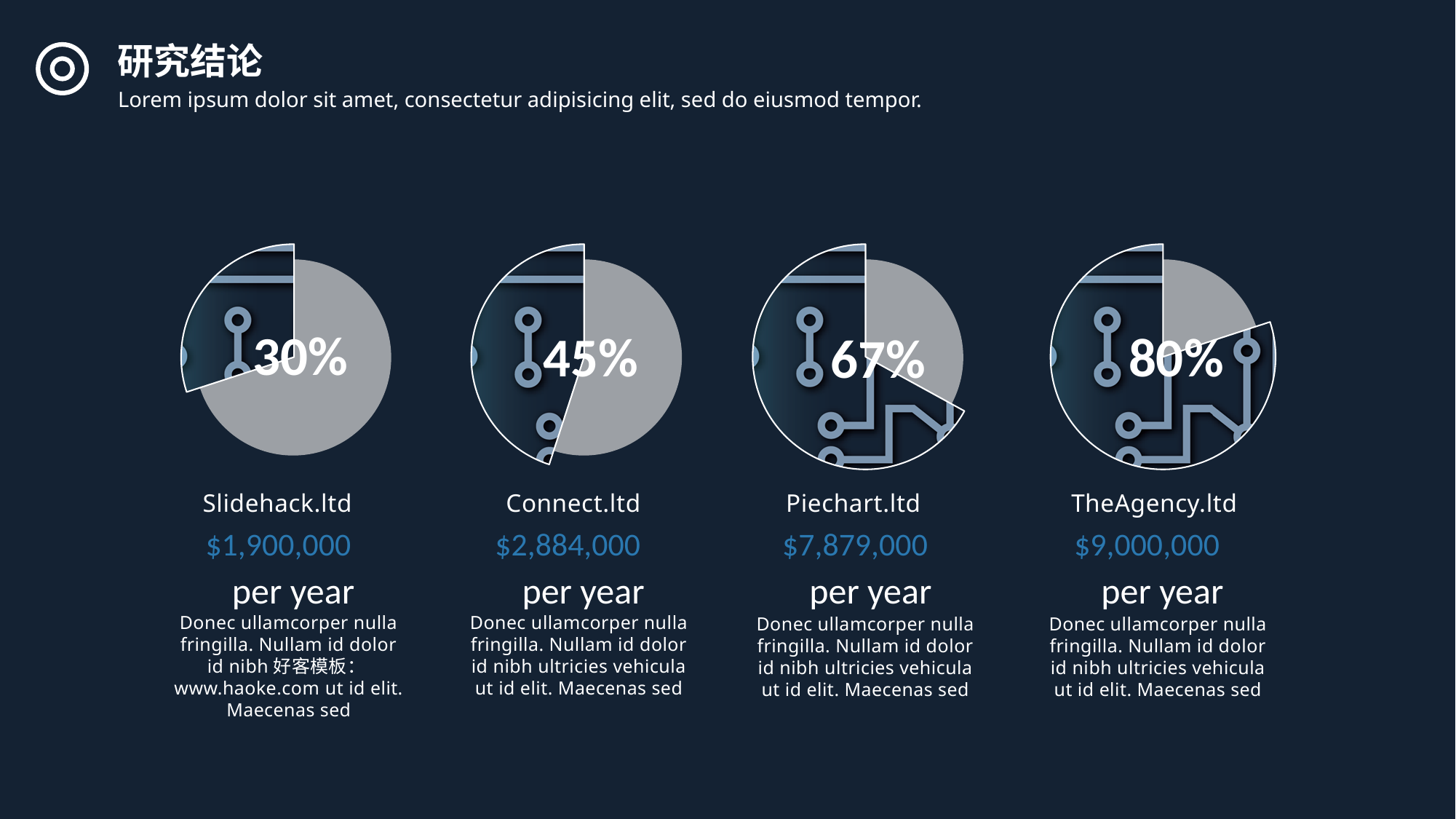
Which company's pie chart shows the highest percentage? TheAgency.ltd How many pie charts are shown on the slide? 4 What is the difference in percentage points between the TheAgency.ltd chart and the Slidehack.ltd chart? 50 What percentage is shown in the pie chart for TheAgency.ltd? 80% What percentage is shown in the pie chart for Piechart.ltd? 67% What is the per-year dollar value shown under the Piechart.ltd chart? $7,879,000 What percentage is shown in the pie chart for Connect.ltd? 45% Which has the larger per-year dollar value, Slidehack.ltd or Connect.ltd? Connect.ltd What kind of chart is used to show each company's percentage on the slide? Pie chart What is the per-year dollar value shown under the Connect.ltd chart? $2,884,000 Which company's pie chart shows the lowest percentage? Slidehack.ltd What percentage is shown in the pie chart for Slidehack.ltd? 30%